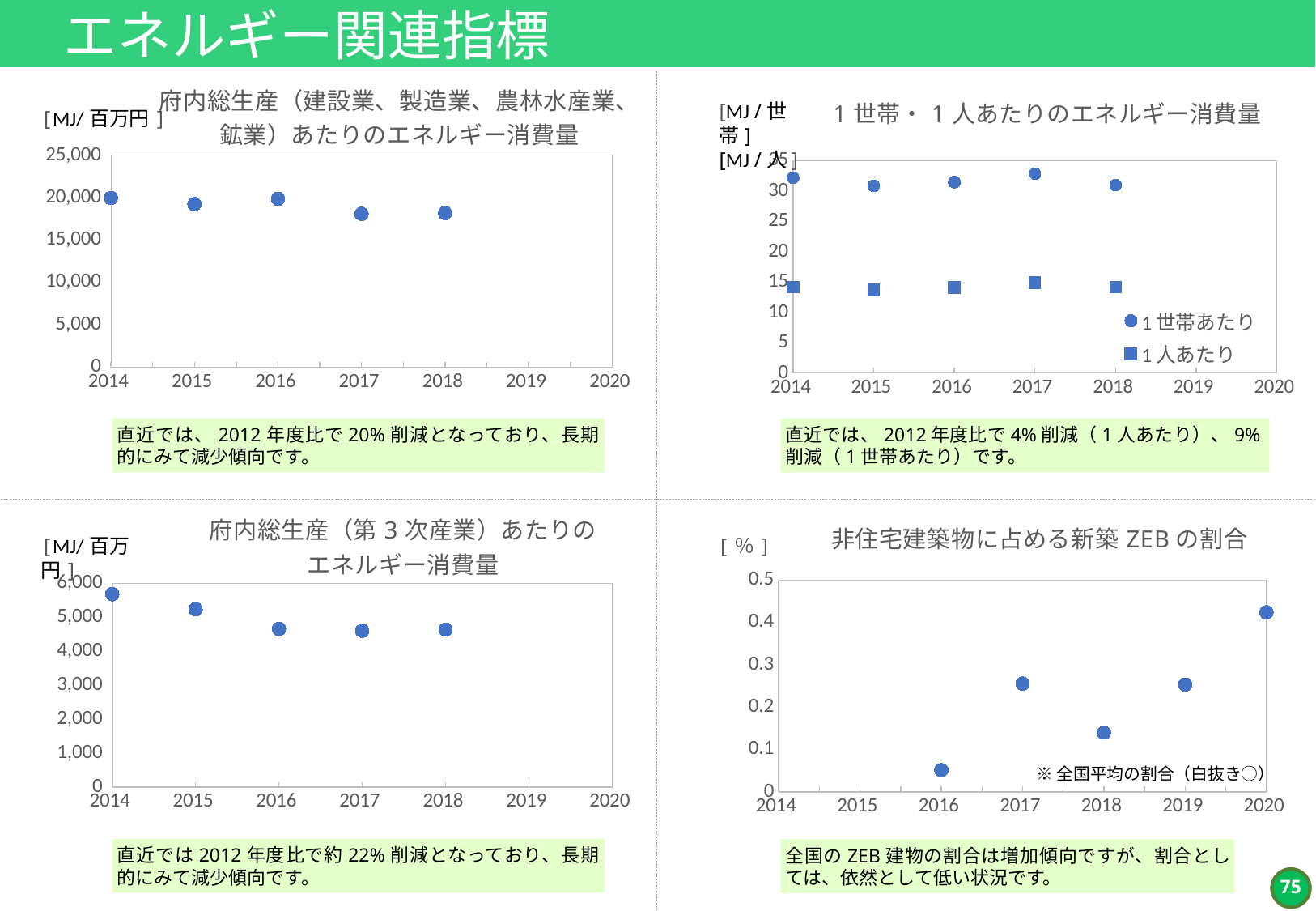
In the bottom-right chart (非住宅建築物に占める新築ZEBの割合), which year has the lowest value? 2016 In the top-left chart (府内総生産（建設業、製造業、農林水産業、鉱業）あたりのエネルギー消費量), is the value for 2014 greater or less than 15,000? greater In the top-right chart (１世帯・１人あたりのエネルギー消費量), how many series does the legend list? 2 What kind of chart is the top-left chart titled 府内総生産（建設業、製造業、農林水産業、鉱業）あたりのエネルギー消費量? Scatter chart In the top-right chart (１世帯・１人あたりのエネルギー消費量), which is larger in 2014, 1世帯あたり or 1人あたり? 1世帯あたり In the top-right chart (１世帯・１人あたりのエネルギー消費量), is the 1人あたり value for 2015 greater or less than 15? less In the bottom-left chart (府内総生産（第３次産業）あたりのエネルギー消費量), is the value for 2016 greater or less than 5,000? less In the bottom-left chart (府内総生産（第３次産業）あたりのエネルギー消費量), which year has the highest value? 2014 In the bottom-left chart (府内総生産（第３次産業）あたりのエネルギー消費量), do the values generally rise or fall from 2014 to 2018? fall In the bottom-right chart (非住宅建築物に占める新築ZEBの割合), which year has the highest value? 2020 In the top-left chart (府内総生産（建設業、製造業、農林水産業、鉱業）あたりのエネルギー消費量), how many data points are plotted? 5